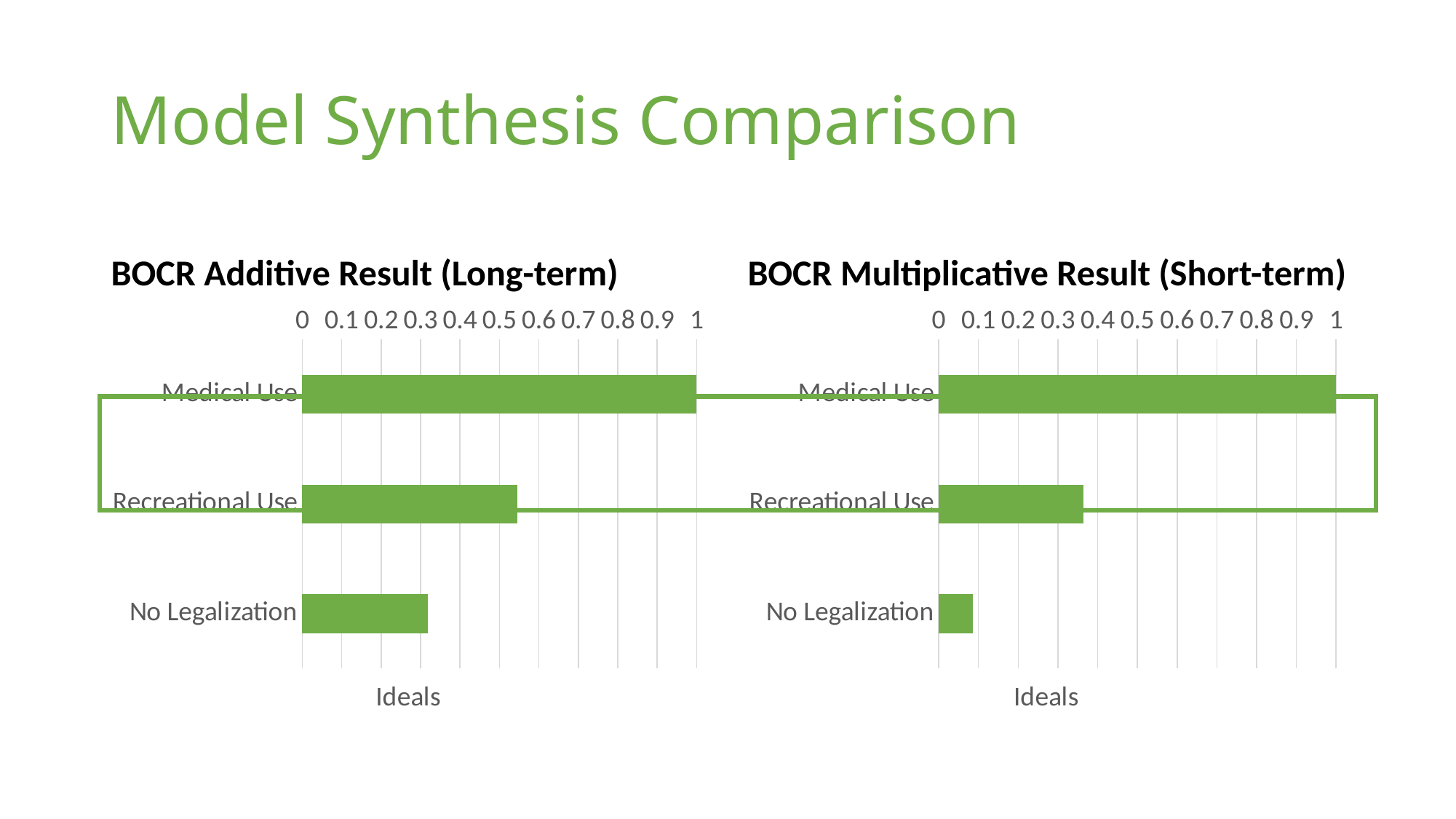
In the BOCR Multiplicative Result (Short-term) chart, which category has the lowest value? No Legalization How many categories are shown in the BOCR Additive Result (Long-term) chart? 3 In the BOCR Multiplicative Result (Short-term) chart, what is the value for Medical Use? 1 What type of chart is the BOCR Multiplicative Result (Short-term) chart? Bar chart In the BOCR Additive Result (Long-term) chart, is the value for No Legalization greater or less than 0.2? greater In the BOCR Multiplicative Result (Short-term) chart, is the value for No Legalization greater or less than 0.2? less In the BOCR Additive Result (Long-term) chart, which category has the highest value? Medical Use In the BOCR Additive Result (Long-term) chart, which category has the lowest value? No Legalization In the BOCR Additive Result (Long-term) chart, what is the value for Medical Use? 1 In the BOCR Additive Result (Long-term) chart, is the value for Recreational Use greater or less than 0.5? greater Which is larger: Recreational Use in the BOCR Additive Result (Long-term) chart or Recreational Use in the BOCR Multiplicative Result (Short-term) chart? BOCR Additive Result (Long-term)